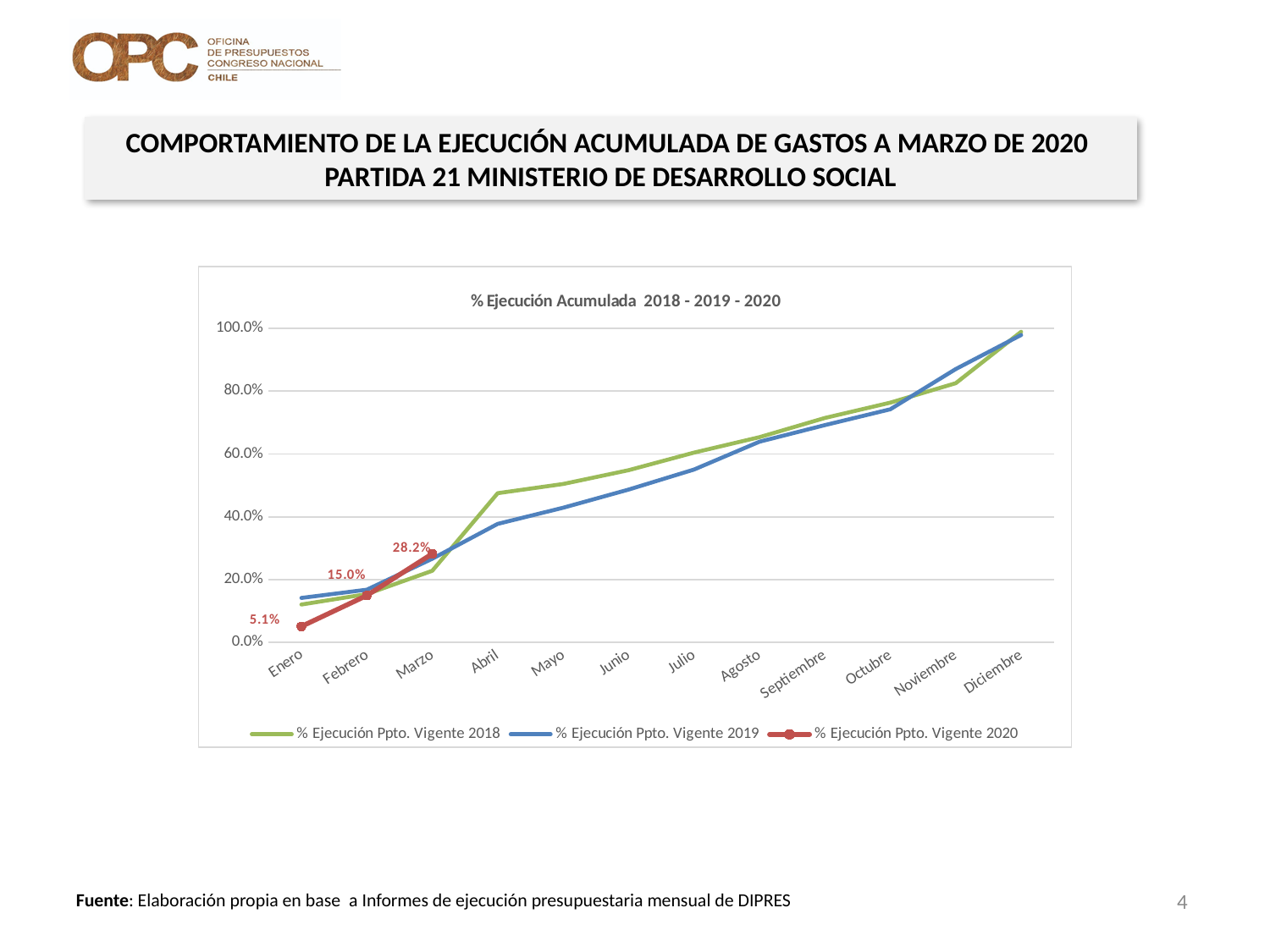
How many series does the legend list? 3 Do the values of the % Ejecución Ppto. Vigente 2020 series rise or fall from Enero to Marzo? Rise Is the value for Abril in the % Ejecución Ppto. Vigente 2019 series greater or less than 40.0%? less Which month has the highest value in the % Ejecución Ppto. Vigente 2020 series? Marzo What is the title of the chart? % Ejecución Acumulada 2018 - 2019 - 2020 What kind of chart is shown on the slide? Line chart In Abril, which series has the larger value: % Ejecución Ppto. Vigente 2018 or % Ejecución Ppto. Vigente 2019? % Ejecución Ppto. Vigente 2018 How many months are shown on the x axis of the chart? 12 What is the value for Febrero in the % Ejecución Ppto. Vigente 2020 series? 15.0% What is the value for Marzo in the % Ejecución Ppto. Vigente 2020 series? 28.2% What is the value for Enero in the % Ejecución Ppto. Vigente 2020 series? 5.1% What is the difference between the Marzo and Febrero values in the % Ejecución Ppto. Vigente 2020 series? 13.2%